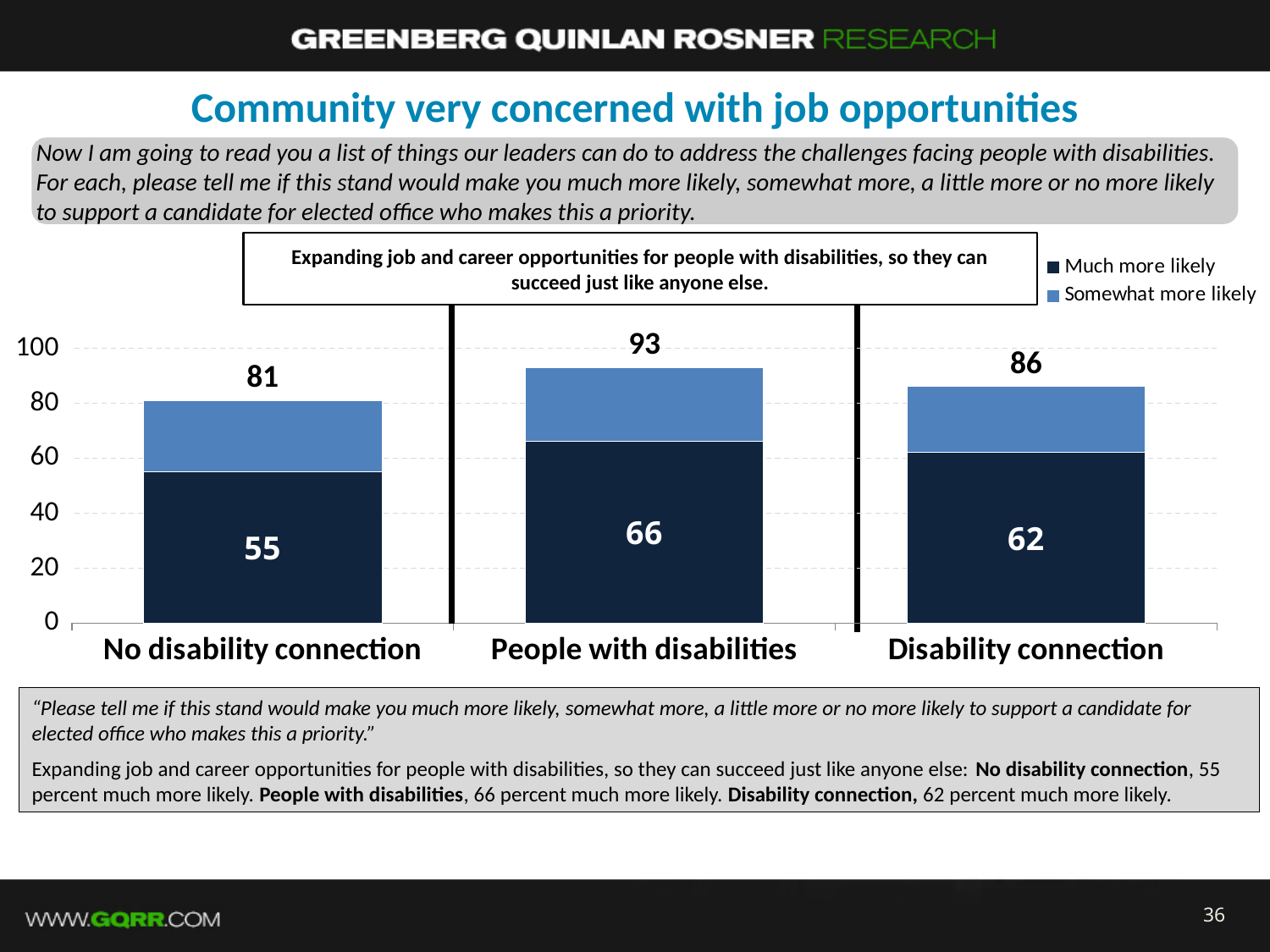
What is the 'Much more likely' value for People with disabilities? 66 What is the 'Much more likely' value for No disability connection? 55 What is the total of the stacked bar for No disability connection? 81 What kind of chart is shown on the slide? Stacked bar chart How many categories are shown on the x axis? 3 What is the total of the stacked bar for People with disabilities? 93 What is the 'Much more likely' value for Disability connection? 62 Which is larger: the stacked bar total for Disability connection or for People with disabilities? People with disabilities What is the difference between the 'Much more likely' values for People with disabilities and No disability connection? 11 Which category has the highest 'Much more likely' value? People with disabilities How many series does the legend list? 2 Which category has the lowest stacked bar total? No disability connection